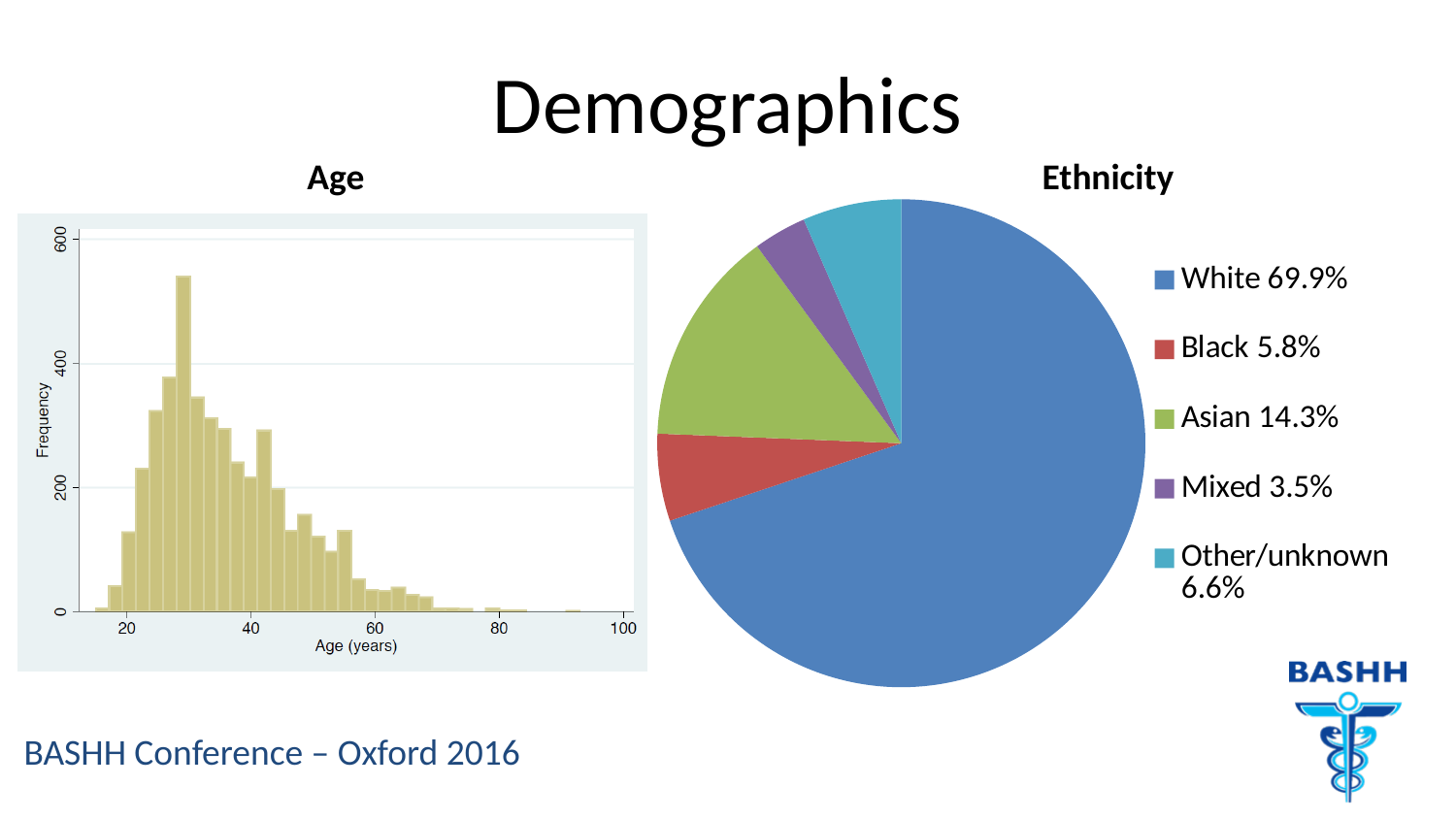
In the Ethnicity pie chart, which is larger, Black or Other/unknown? Other/unknown In the Ethnicity pie chart, what percentage is Other/unknown? 6.6% What kind of chart is the Ethnicity chart? Pie chart What kind of chart is the Age chart? Bar chart In the Age chart, what is the label of the x axis? Age (years) In the Age chart, is the frequency of the tallest bar (around age 30) greater or less than 400? greater In the Ethnicity pie chart, what is the difference in percentage points between Asian and Black? 8.5 In the Ethnicity pie chart, what percentage is White? 69.9% In the Ethnicity pie chart, what percentage is Asian? 14.3% How many categories does the Ethnicity pie chart show? 5 In the Ethnicity pie chart, which category has the smallest share? Mixed In the Ethnicity pie chart, which category has the largest share? White